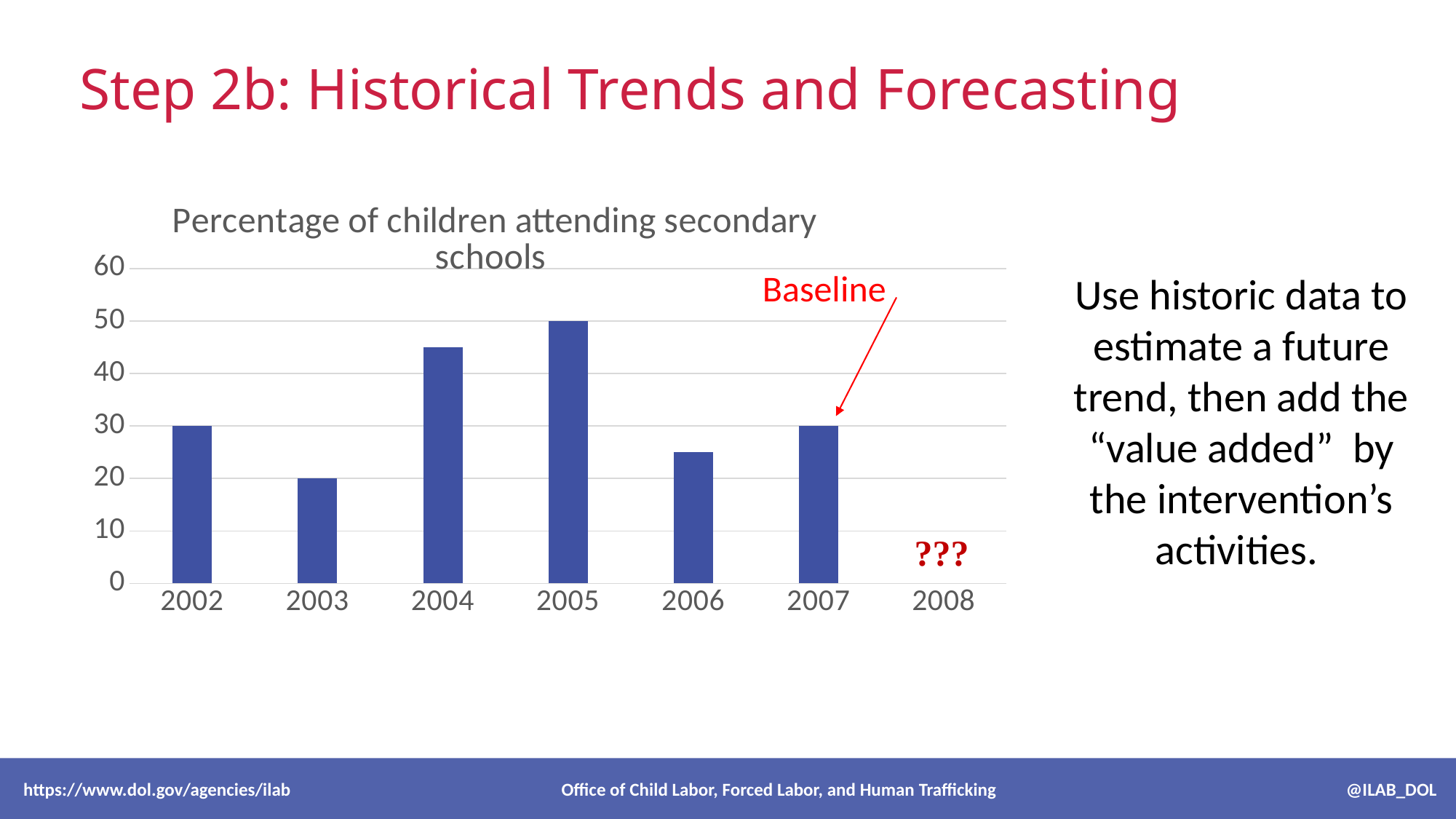
What is the value for 2002? 30 What is the difference between the values for 2005 and 2003? 30 What is the value for 2003? 20 What is the value for 2007? 30 What is the value for 2005? 50 What type of chart is shown on the slide? bar chart Which year has the lowest bar? 2003 Is the value for 2004 greater or less than 40? greater What is the title of the chart? Percentage of children attending secondary schools Which year is labelled as the Baseline? 2007 Is the value for 2006 greater or less than 30? less Which year has the highest bar? 2005